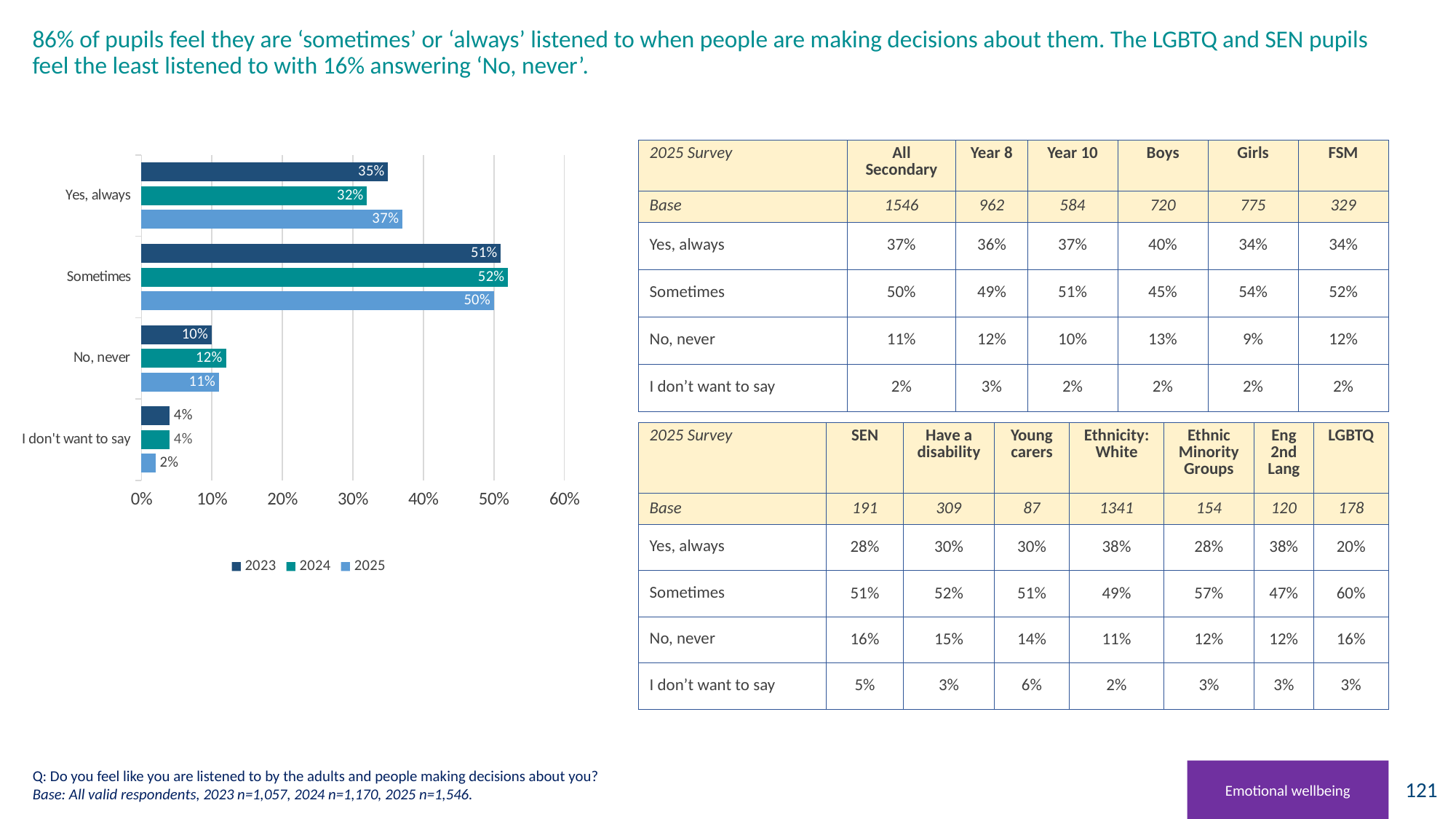
How many series does the chart legend list? 3 What is the difference between the 2025 and 2024 values for 'Yes, always' in the chart? 5% What is the 2024 value for 'Sometimes' in the chart? 52% What is the 2025 value for 'I don't want to say' in the chart? 2% How many response categories are shown on the chart? 4 Which response category has the highest value for 2025 in the chart? Sometimes Which series in the chart legend is shown in the darkest blue colour? 2023 What is the 2025 value for 'Yes, always' in the chart? 37% Which is larger in the chart: the 2023 value for 'Yes, always' or the 2024 value for 'Yes, always'? 2023 What is the 2023 value for 'No, never' in the chart? 10% Which response category has the lowest value for 2023 in the chart? I don't want to say What kind of chart is shown on the slide? bar chart